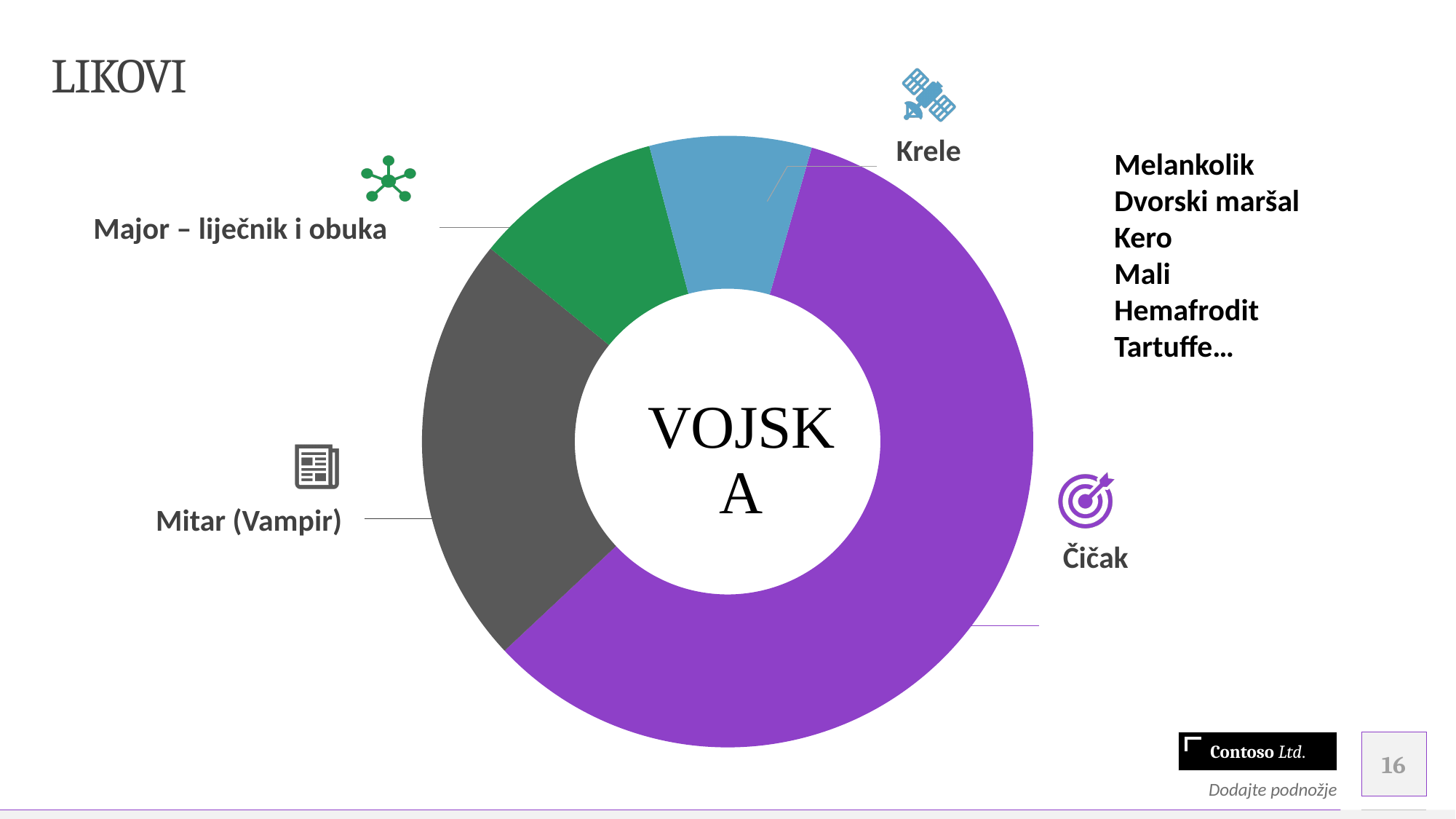
Does the Čičak segment take up more or less than half of the doughnut chart? more Which segment is larger, Mitar (Vampir) or Krele? Mitar (Vampir) Which segment of the doughnut chart is the largest? Čičak Which segment is larger, Čičak or Major – liječnik i obuka? Čičak Which segment of the doughnut chart is the smallest? Krele What colour is the Mitar (Vampir) segment of the doughnut chart? Gray Which segment is larger, Major – liječnik i obuka or Krele? Major – liječnik i obuka What word is written in the centre of the doughnut chart? VOJSKA How many segments does the doughnut chart have? 4 What kind of chart is shown on the slide? Doughnut (pie) chart